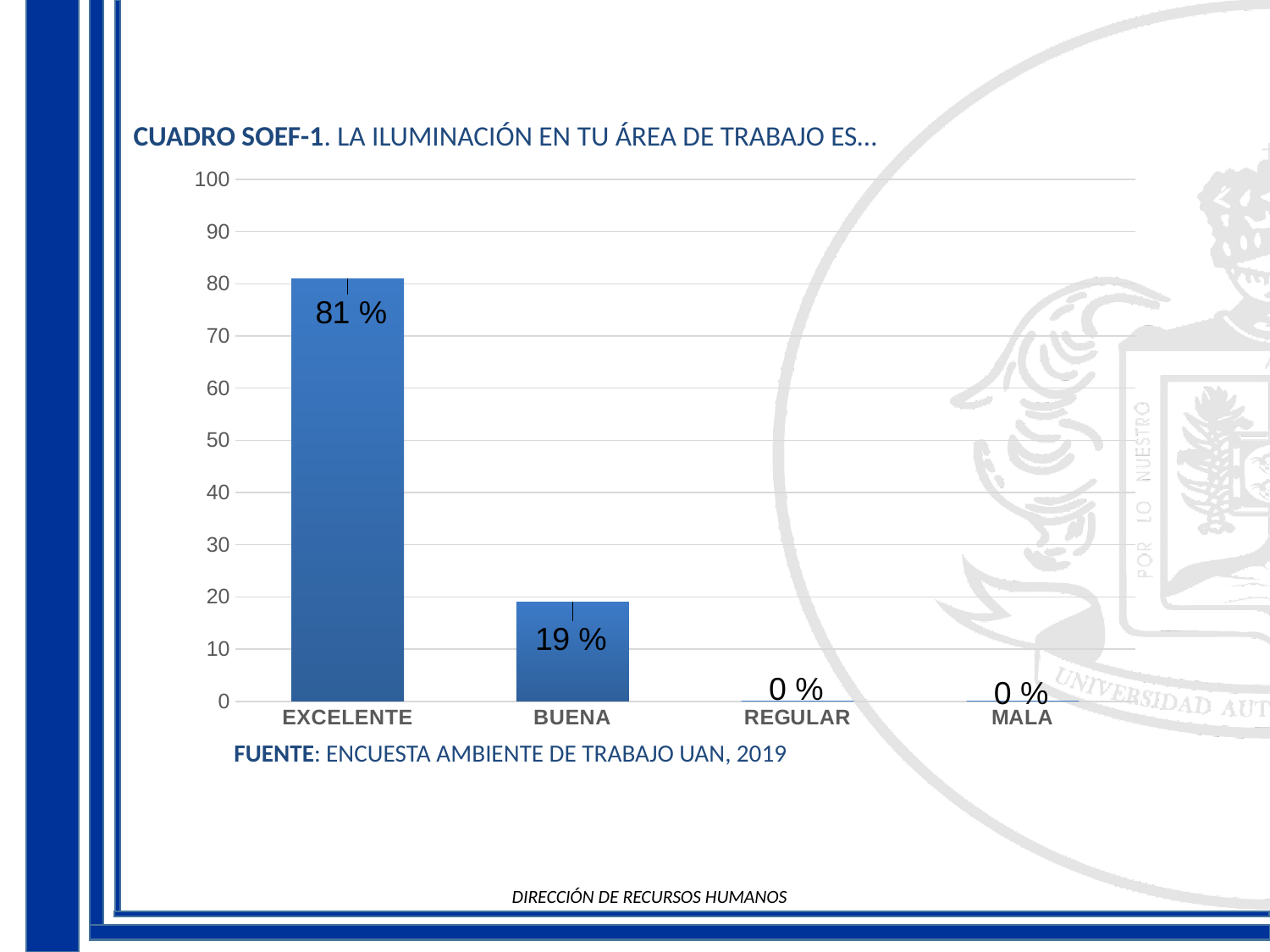
Which category has the highest value? EXCELENTE Which is larger, the value for BUENA or the value for REGULAR? BUENA What is the value for EXCELENTE? 81 % What kind of chart is shown on the slide? bar chart What is the value for MALA? 0 % Is the value for BUENA greater or less than 30? less Is the value for EXCELENTE greater or less than 50? greater What is the value for BUENA? 19 % What is the difference between the values for EXCELENTE and BUENA? 62 % How many categories are shown on the x axis? 4 What is the source cited below the chart? ENCUESTA AMBIENTE DE TRABAJO UAN, 2019 What is the value for REGULAR? 0 %